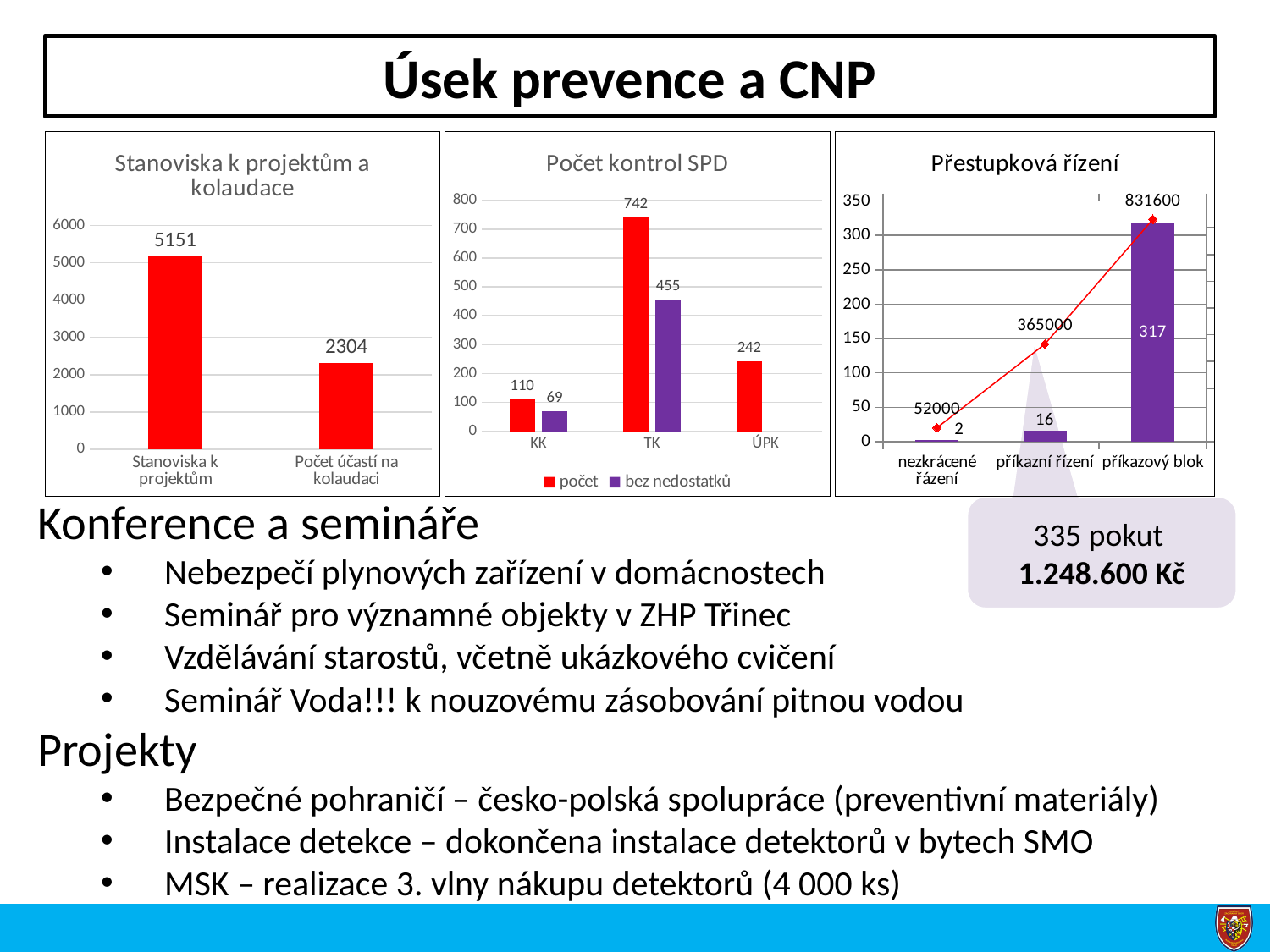
In the chart 'Stanoviska k projektům a kolaudace', what is the value for 'Stanoviska k projektům'? 5151 In the chart 'Počet kontrol SPD', what is the difference between 'počet' and 'bez nedostatků' for TK? 287 In the chart 'Počet kontrol SPD', what is the 'bez nedostatků' value for KK? 69 In the chart 'Přestupková řízení', what is the line value for 'příkazní řízení'? 365000 In the chart 'Přestupková řízení', do the line values rise or fall from left to right? rise In the chart 'Přestupková řízení', what is the bar value for 'příkazový blok'? 317 How many categories are shown on the x axis of the chart 'Přestupková řízení'? 3 In the chart 'Počet kontrol SPD', which category has the highest 'počet' value? TK In the chart 'Stanoviska k projektům a kolaudace', what is the difference between 'Stanoviska k projektům' and 'Počet účastí na kolaudaci'? 2847 What kind of chart is 'Stanoviska k projektům a kolaudace'? bar chart In the chart 'Počet kontrol SPD', what is the 'počet' value for TK? 742 In the chart 'Počet kontrol SPD', how many series does the legend list? 2